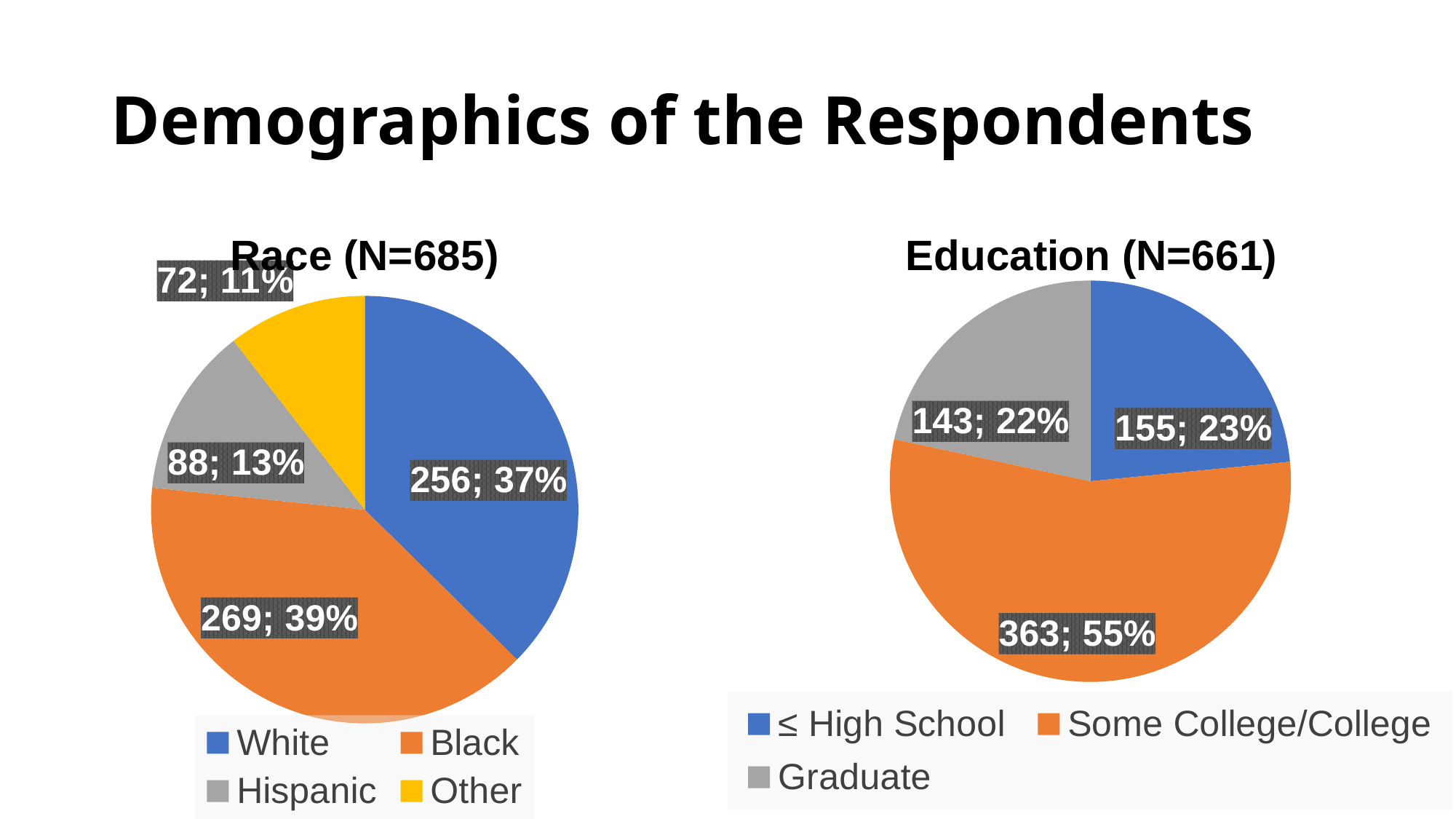
In the Race (N=685) chart, which category has the smallest slice? Other In the Race (N=685) chart, how many more Hispanic respondents are there than Other respondents? 16 In the Education (N=661) chart, which is larger: ≤ High School or Graduate? ≤ High School What type of chart is the Education (N=661) chart? Pie chart In the Education (N=661) chart, how many respondents have Some College/College? 363 In the Race (N=685) chart, which category has the largest slice? Black In the Education (N=661) chart, which category has the largest slice? Some College/College In the Education (N=661) chart, what share of respondents are Graduate? 22% In the Race (N=685) chart, how many respondents are Black? 269 In the Race (N=685) chart, what percentage of respondents are White? 37% In the Race (N=685) chart, what colour represents the Other category? Yellow How many categories does the Race (N=685) pie chart show? 4